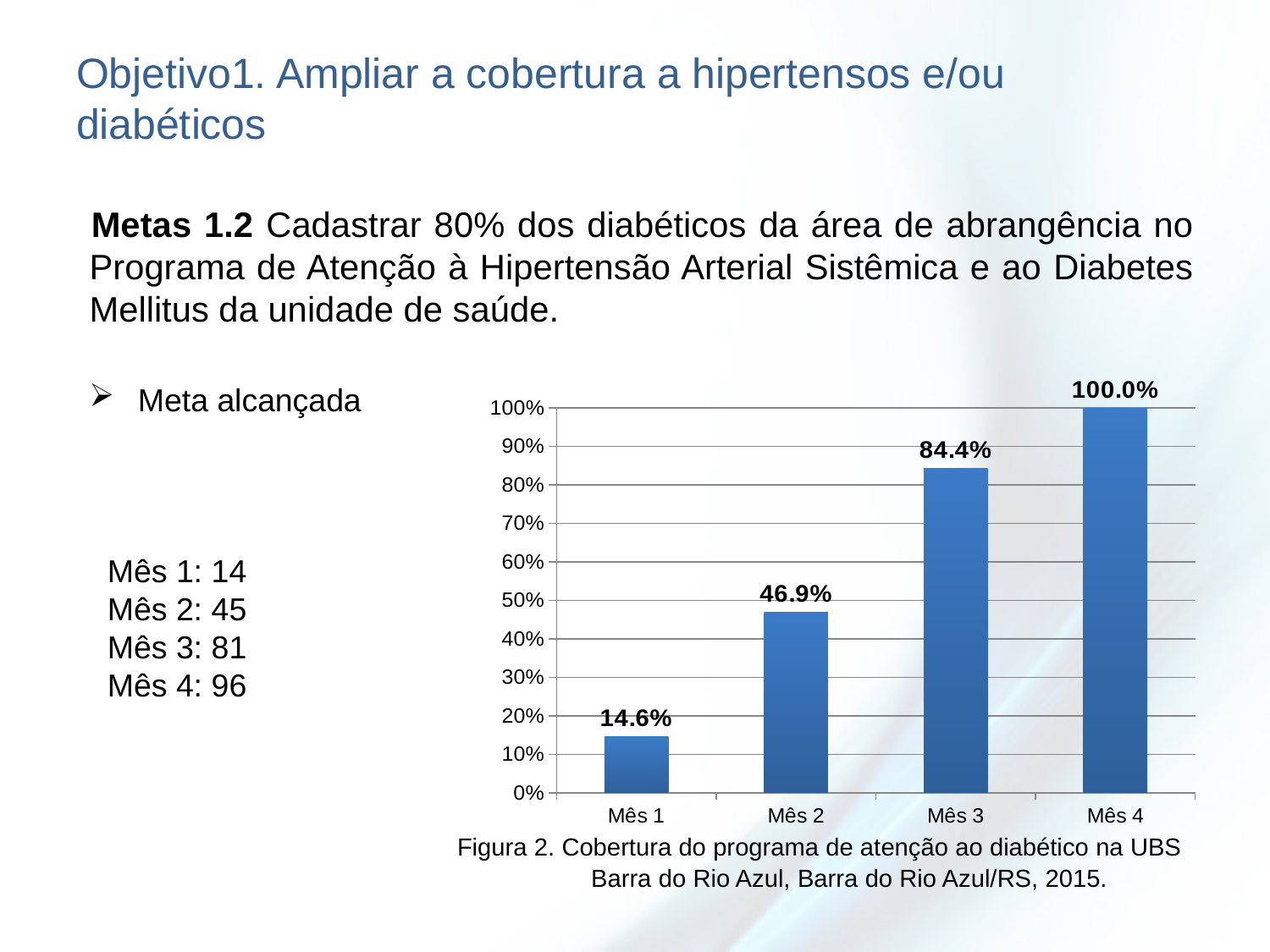
What kind of chart is shown? bar chart Do the values rise or fall from Mês 1 to Mês 4? rise What is the value for Mês 4? 100.0% Which month has the highest value? Mês 4 How many months are shown on the x axis? 4 What is the value for Mês 3? 84.4% Which month has the lowest value? Mês 1 What is the value for Mês 2? 46.9% What is the difference between the values for Mês 3 and Mês 2? 37.5% What is the value for Mês 1? 14.6% Which is larger, the value for Mês 2 or the value for Mês 3? Mês 3 Is the value for Mês 2 greater or less than 50%? less